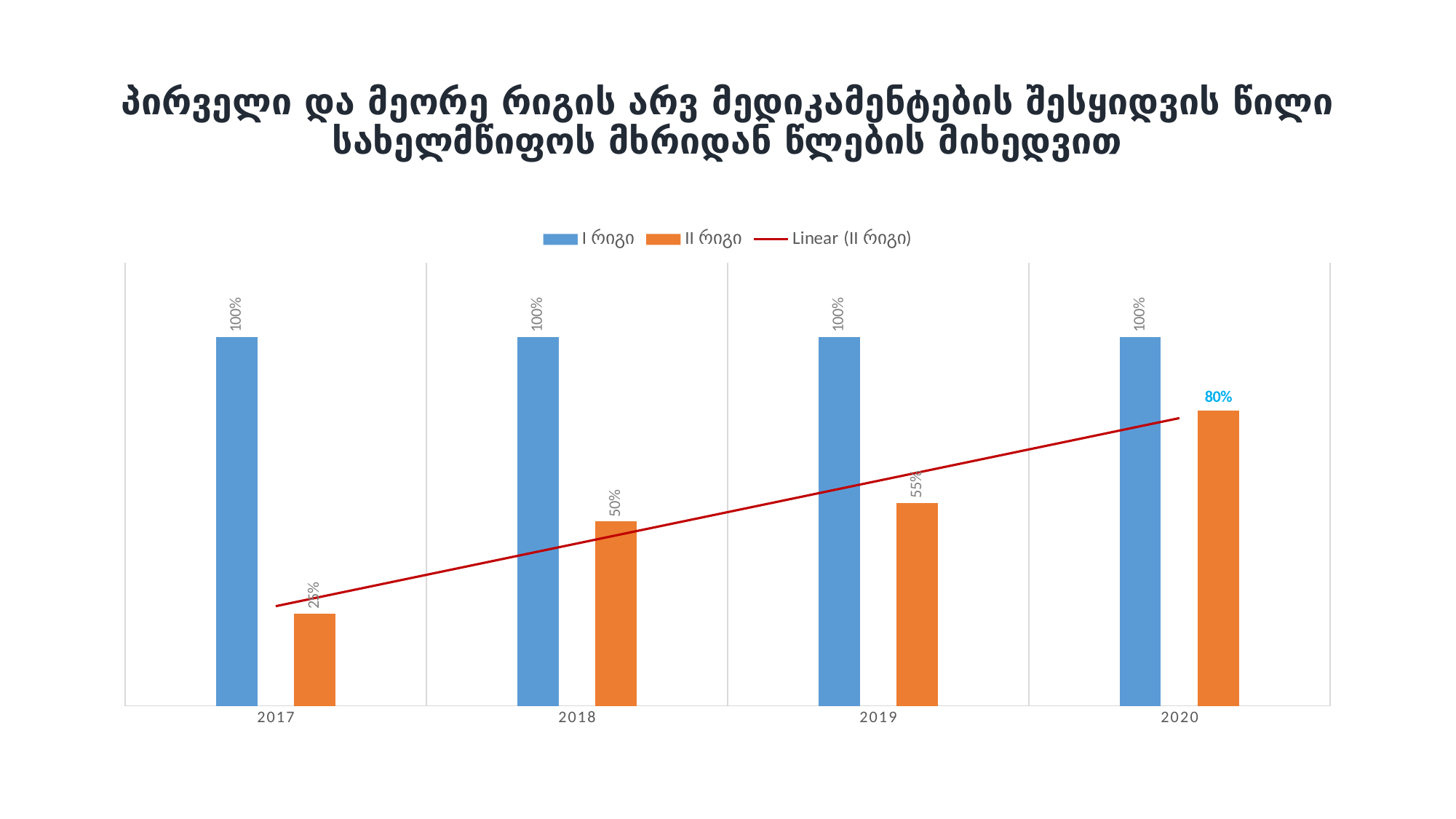
Do the II რიგი values rise or fall from 2017 to 2020? Rise What is the value for II რიგი in 2017? 25% What is the value for II რიგი in 2020? 80% What is the difference between the II რიგი values for 2020 and 2017? 55% In which year is the II რიგი value lowest? 2017 How many years are shown on the x axis? 4 What kind of chart is shown on the slide? Bar chart In which year is the II რიგი value highest? 2020 Which is larger, the II რიგი value for 2019 or for 2018? 2019 What is the value for II რიგი in 2018? 50% What is the value for I რიგი in 2019? 100% How many entries does the legend list? 3